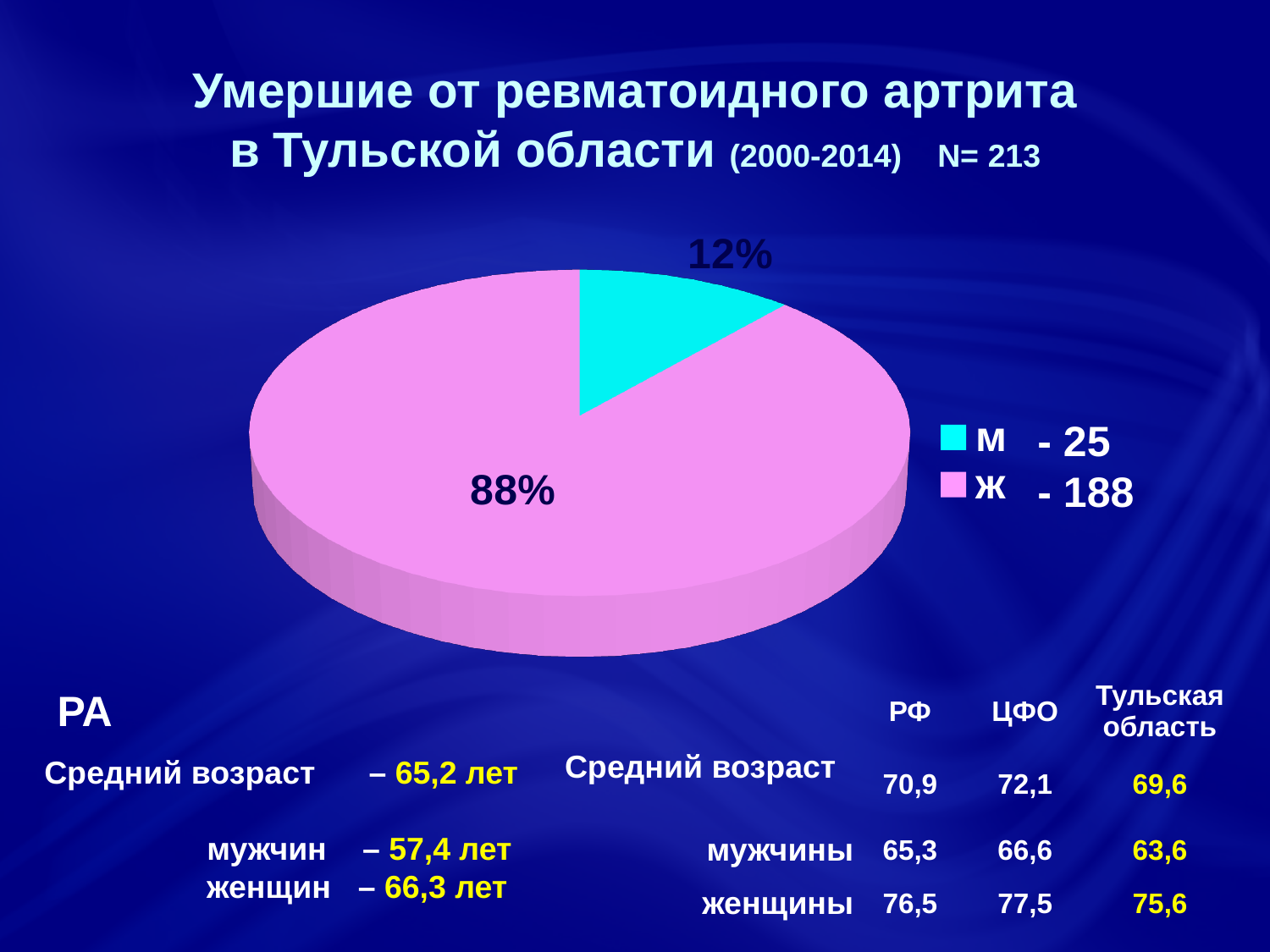
How many entries does the legend list? 2 What count is shown next to "М" in the legend? 25 Which slice is the smallest in the pie chart? М What is the difference in percentage points between the "Ж" and "М" slices? 76 What share of the pie does the "М" slice represent? 12% What count is shown next to "Ж" in the legend? 188 Which is larger, the "М" slice or the "Ж" slice? Ж What kind of chart is shown on the slide? pie chart Which slice is the largest in the pie chart? Ж How many slices does the pie chart have? 2 What share of the pie does the "Ж" slice represent? 88% What colour is the "М" slice in the pie chart? cyan